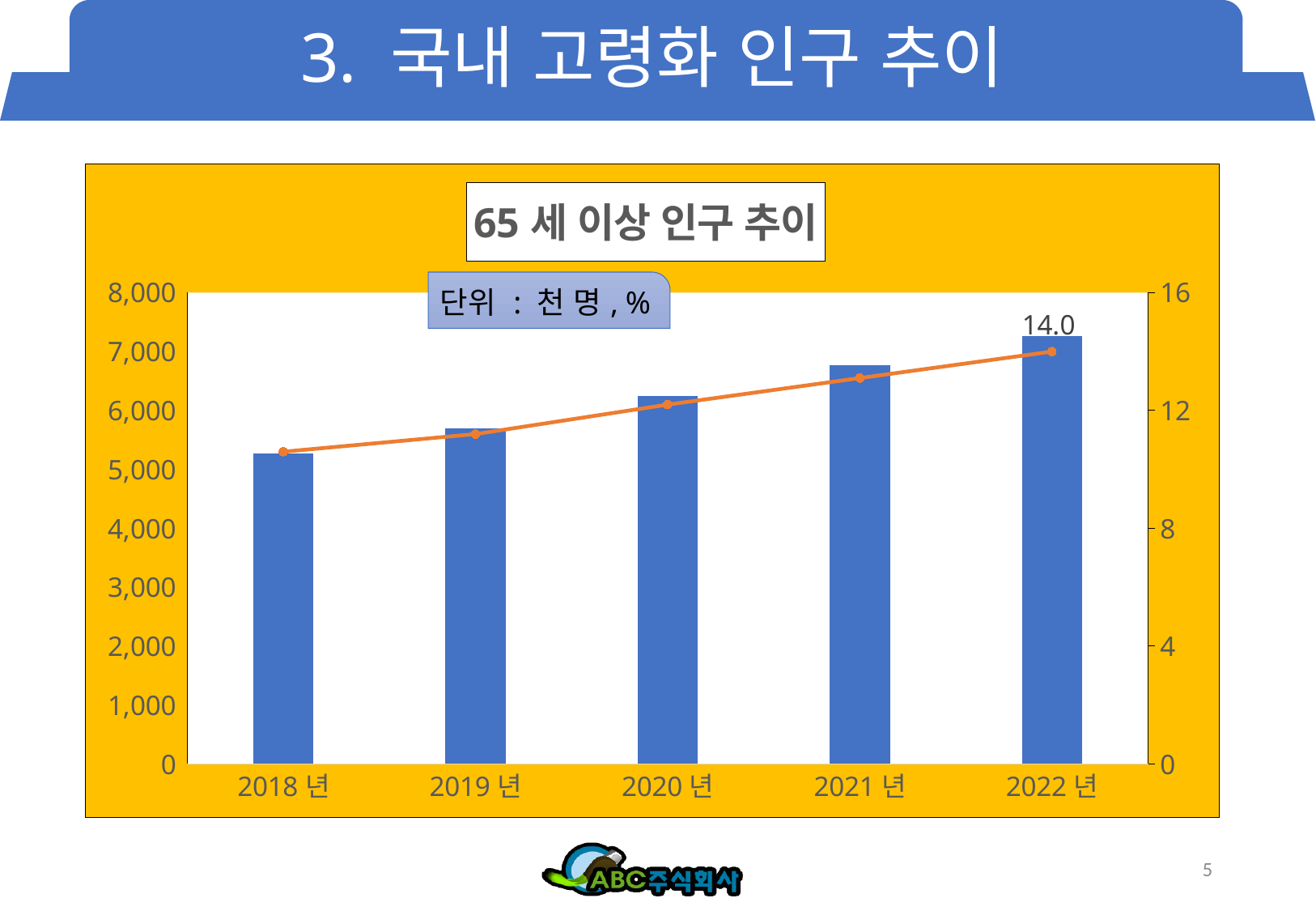
What is the data label shown on the line for 2022 년? 14.0 Which year has the shortest bar? 2018 년 Which year has the tallest bar? 2022 년 How many years are shown on the x axis? 5 Do the bar values rise or fall from 2018 년 to 2022 년? Rise Is the bar value for 2019 년 greater or less than 6,000? less Is the bar value for 2018 년 greater or less than 5,000? greater What is the title of the chart? 65 세 이상 인구 추이 What units does the chart state it uses? 천 명, % Which has the larger bar value, 2019 년 or 2021 년? 2021 년 What kind of chart is this? A bar chart combined with a line chart Is the bar value for 2022 년 greater or less than 7,000? greater